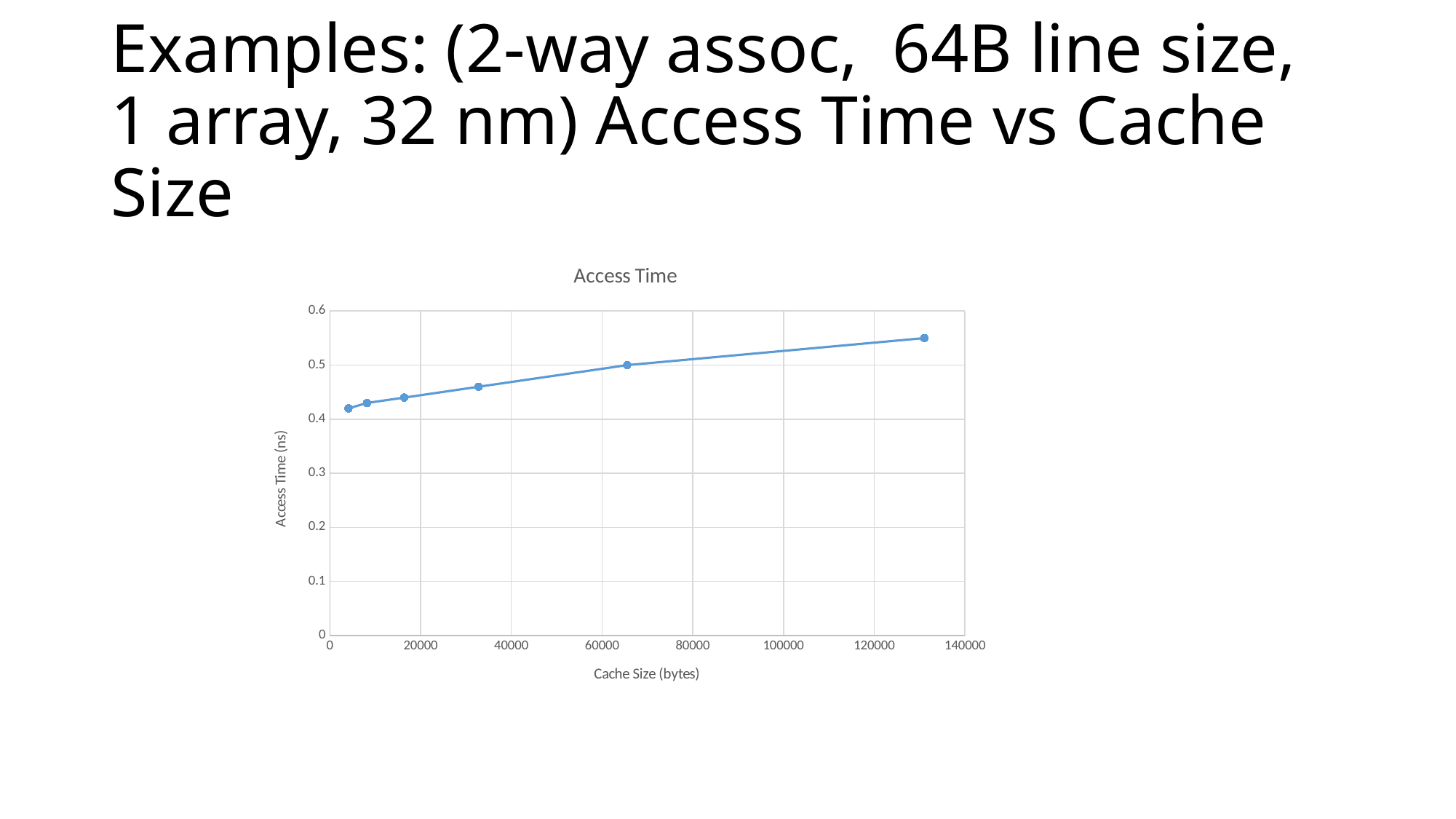
How many data points are plotted on the Access Time chart? 6 Is the access time for the largest cache size (rightmost point) greater or less than 0.5 ns? greater What is the label on the x axis of the chart? Cache Size (bytes) Is the access time for the smallest cache size (leftmost point) greater or less than 0.5 ns? less What is the title of the chart? Access Time Which plotted point has the lowest access time? the leftmost point (smallest cache size) Does access time rise or fall as cache size increases along the x axis? rise Is the access time for the largest cache size (rightmost point) greater or less than 0.6 ns? less What kind of chart is shown on the slide? line chart Which plotted point has the highest access time? the rightmost point (largest cache size) Which has the larger access time: the point at the largest cache size or the point at the smallest cache size? the largest cache size